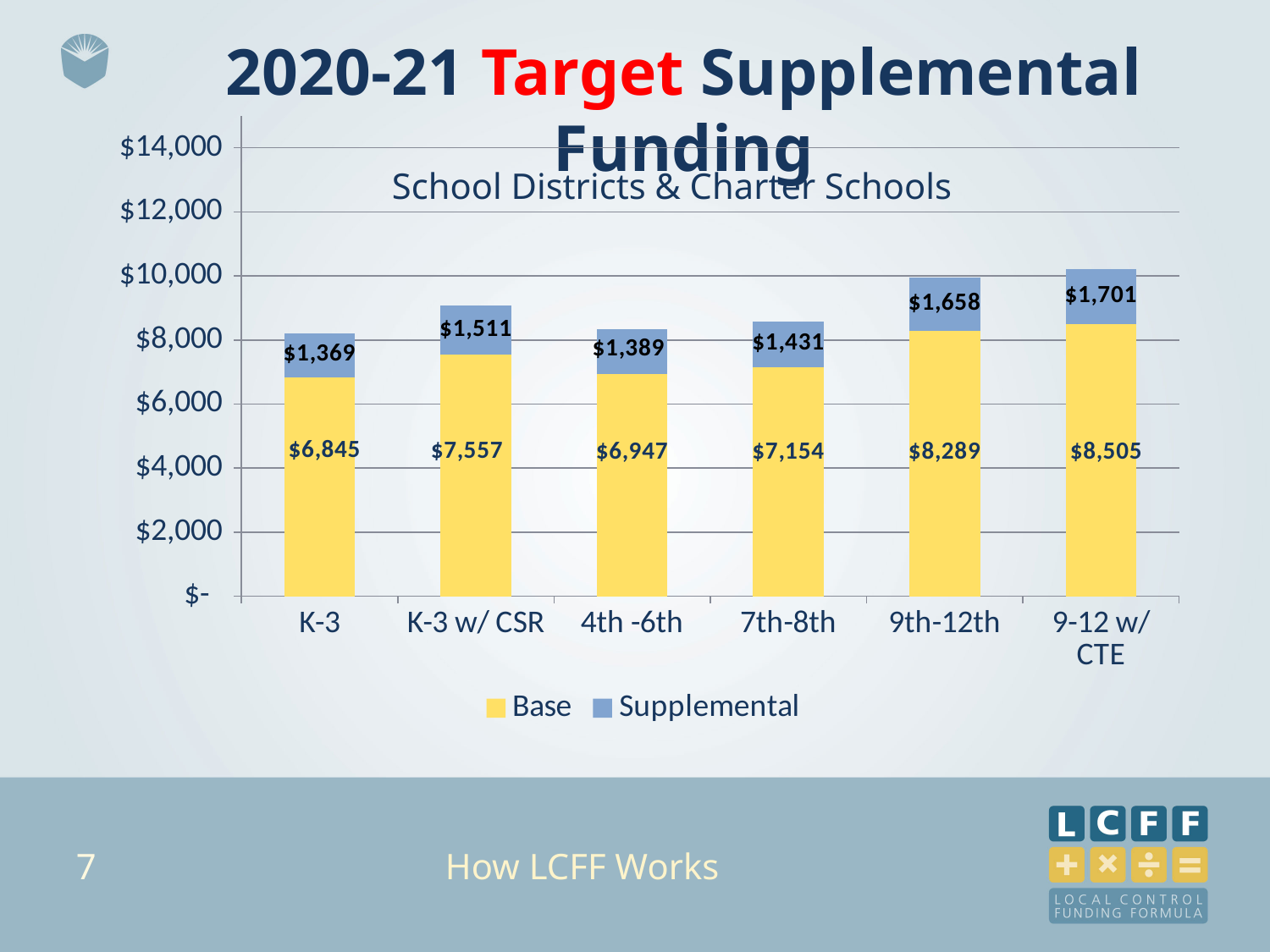
What kind of chart is shown on the slide? Stacked bar chart Which category has the lowest Supplemental value? K-3 What is the difference between the Base values for 9-12 w/ CTE and 9th-12th? $216 How many series does the legend list? 2 What is the Base value for 4th -6th? $6,947 What is the Supplemental value for 9th-12th? $1,658 How many categories are shown on the x axis? 6 What is the Base value for K-3 w/ CSR? $7,557 What is the total of the stacked bar for K-3? $8,214 Which is larger, the Supplemental value for 7th-8th or for 4th -6th? 7th-8th Which category has the highest Base value? 9-12 w/ CTE What is the total of the stacked bar for 9-12 w/ CTE? $10,206